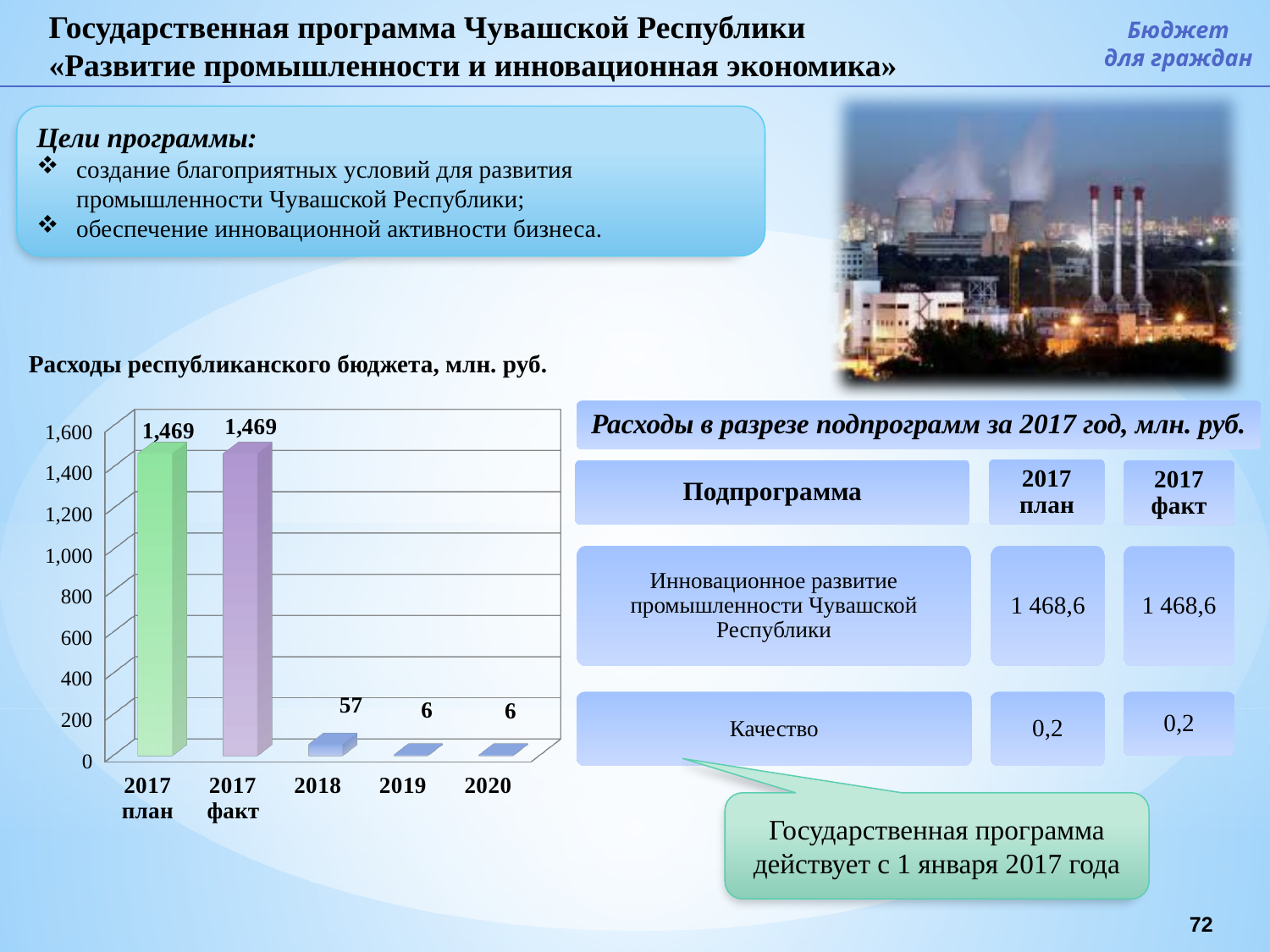
Is the value for 2017 факт greater or less than 1,400 in the chart 'Расходы республиканского бюджета, млн. руб.'? greater Which category has the lowest value in the chart 'Расходы республиканского бюджета, млн. руб.'? 2019 and 2020 (both 6) What kind of chart is 'Расходы республиканского бюджета, млн. руб.'? bar chart What is the value for 2017 план in the chart 'Расходы республиканского бюджета, млн. руб.'? 1,469 How many categories are shown on the x axis of the chart 'Расходы республиканского бюджета, млн. руб.'? 5 What is the value for 2018 in the chart 'Расходы республиканского бюджета, млн. руб.'? 57 Is the value for 2018 greater or less than 200 in the chart 'Расходы республиканского бюджета, млн. руб.'? less Which is larger in the chart 'Расходы республиканского бюджета, млн. руб.': the value for 2018 or the value for 2020? 2018 Do the values in the chart 'Расходы республиканского бюджета, млн. руб.' rise or fall from 2017 факт to 2020? fall What is the difference between the values for 2017 факт and 2018 in the chart 'Расходы республиканского бюджета, млн. руб.'? 1,412 What is the value for 2020 in the chart 'Расходы республиканского бюджета, млн. руб.'? 6 What is the difference between the values for 2018 and 2019 in the chart 'Расходы республиканского бюджета, млн. руб.'? 51